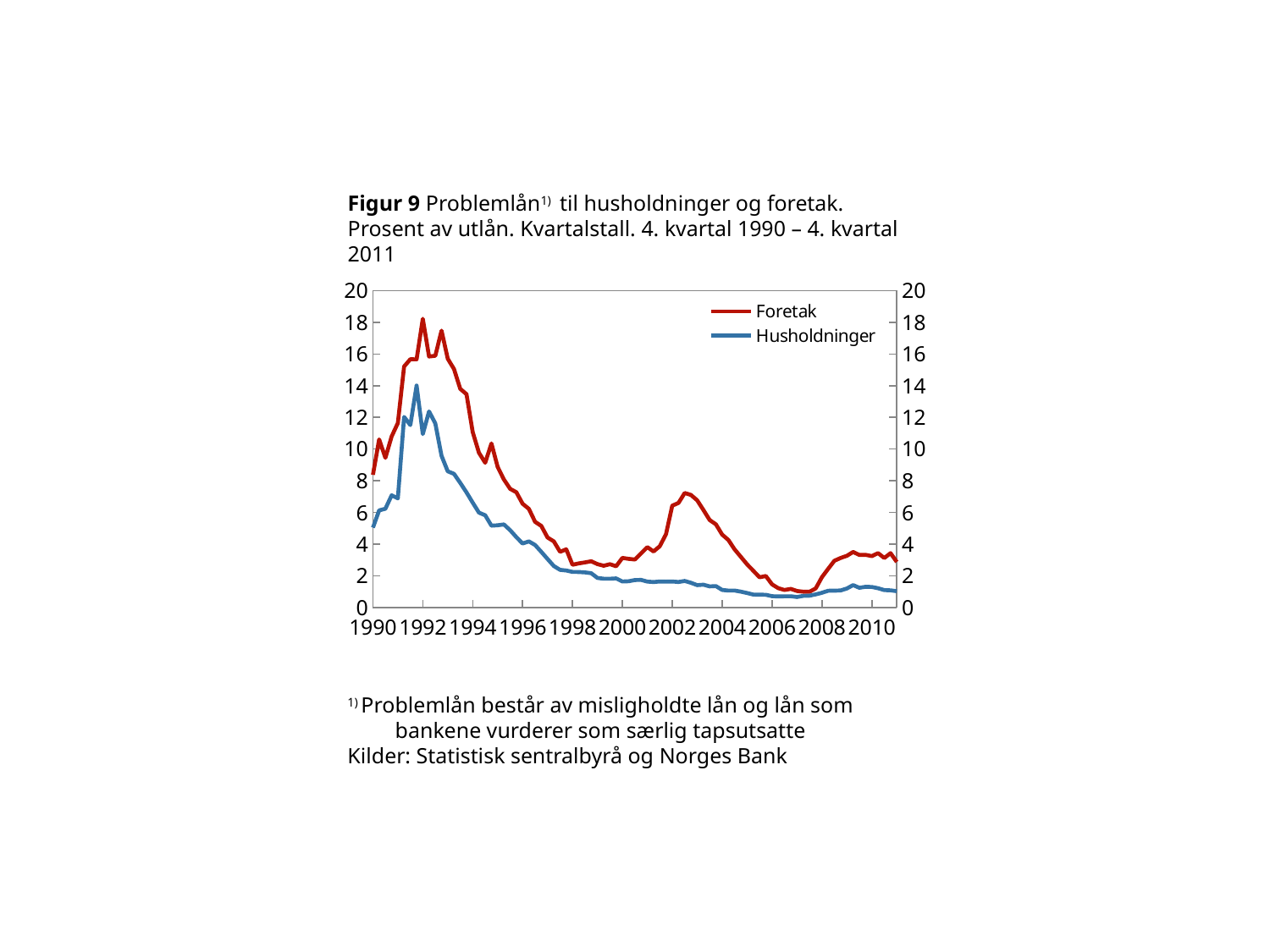
What kind of chart is shown on the slide? Line chart Which series is drawn in red? Foretak Does the Husholdninger series rise or fall between 1992 and 2006? Fall Is the peak value of the Husholdninger series around 1992 greater or less than 12? greater Is the peak value of the Foretak series around 1992 greater or less than 16? greater Which series reaches the higher peak value over the whole period, Foretak or Husholdninger? Foretak Which series is drawn in blue? Husholdninger In 2002, which series has the higher value, Foretak or Husholdninger? Foretak How many series does the legend list? 2 Is the value of the Foretak series at its local peak around 2002–2003 greater or less than 6? greater